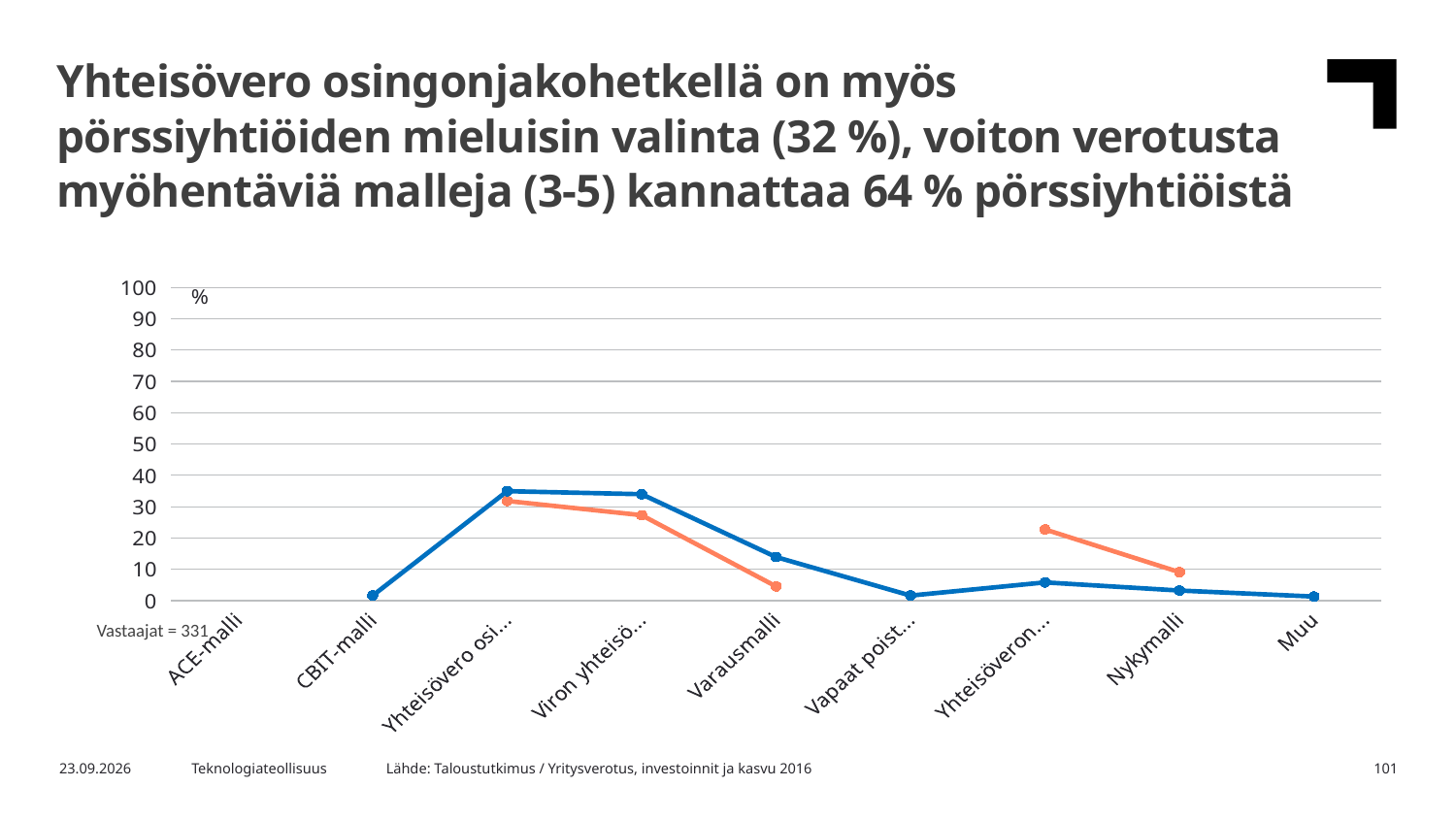
Is the value of the blue line for 'Yhteisövero osi...' greater or less than 20? greater Is the value of the orange line for 'Nykymalli' greater or less than 20? less At 'Varausmalli', which line has the larger value, the blue or the orange? blue What kind of chart is shown on the slide? line chart How many lines (series) are plotted on the chart? 2 Is the value of the blue line for 'Varausmalli' greater or less than 20? less For which category does the orange line reach its highest value? Yhteisövero osi... How many categories are shown on the x axis of the chart? 9 What unit label is shown at the top of the y axis? % At 'Yhteisöveron...', which line has the larger value, the blue or the orange? orange